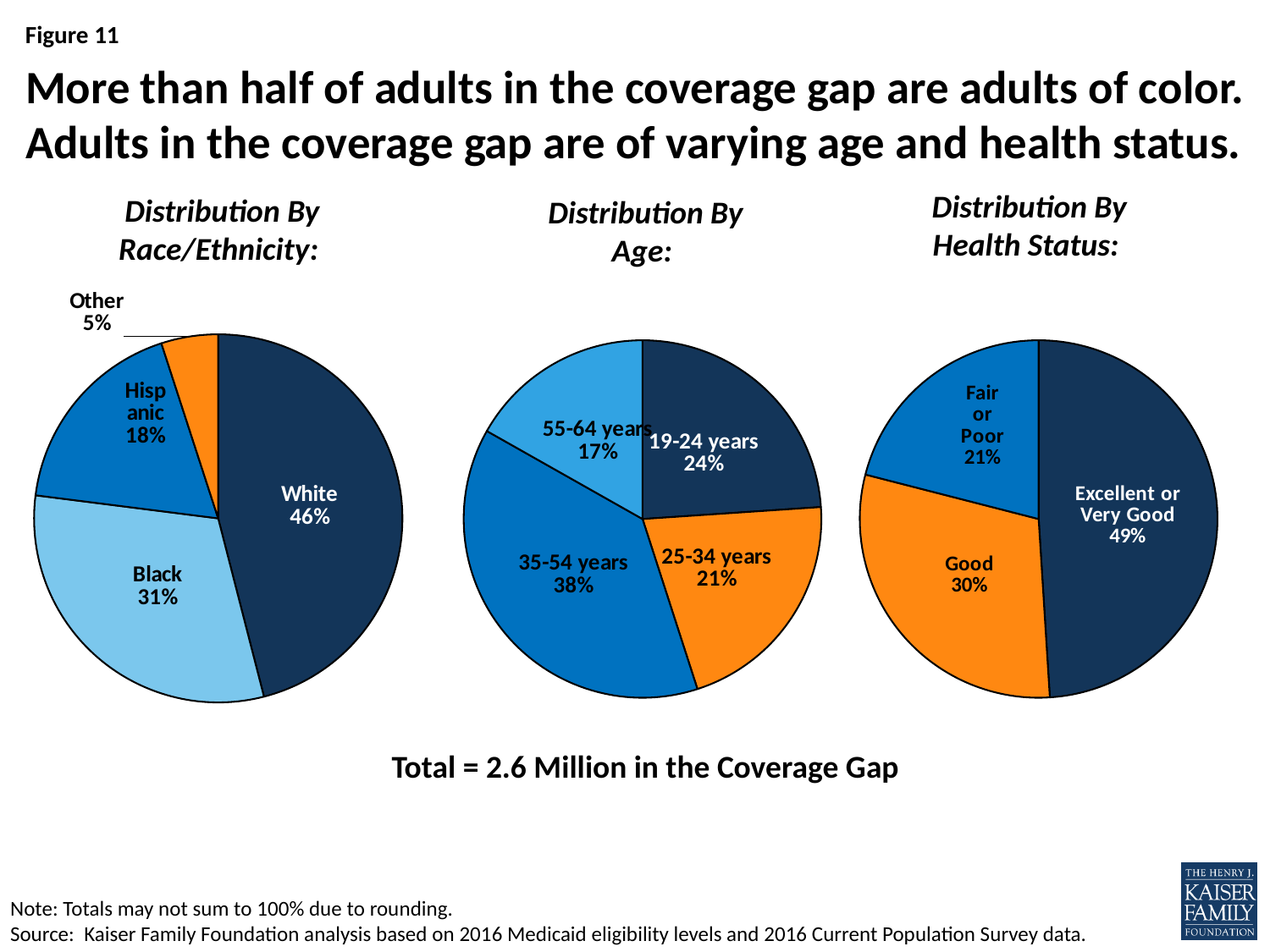
In the Distribution By Race/Ethnicity pie chart, what share of adults in the coverage gap are White? 46% In the Distribution By Health Status pie chart, what share is Good? 30% In the Distribution By Age pie chart, what is the difference between the 19-24 years share and the 55-64 years share? 7% What kind of chart is used for the Distribution By Race/Ethnicity? Pie chart In the Distribution By Age pie chart, what share is 35-54 years? 38% In the Distribution By Age pie chart, which age group has the largest share? 35-54 years In the Distribution By Race/Ethnicity pie chart, what is the difference between the White share and the Hispanic share? 28% In the Distribution By Health Status pie chart, which category has the largest share? Excellent or Very Good In the Distribution By Race/Ethnicity pie chart, which category has the smallest share? Other In the Distribution By Race/Ethnicity pie chart, what share is Black? 31% How many slices does the Distribution By Age pie chart have? 4 In the Distribution By Health Status pie chart, which is larger, Good or Fair or Poor? Good